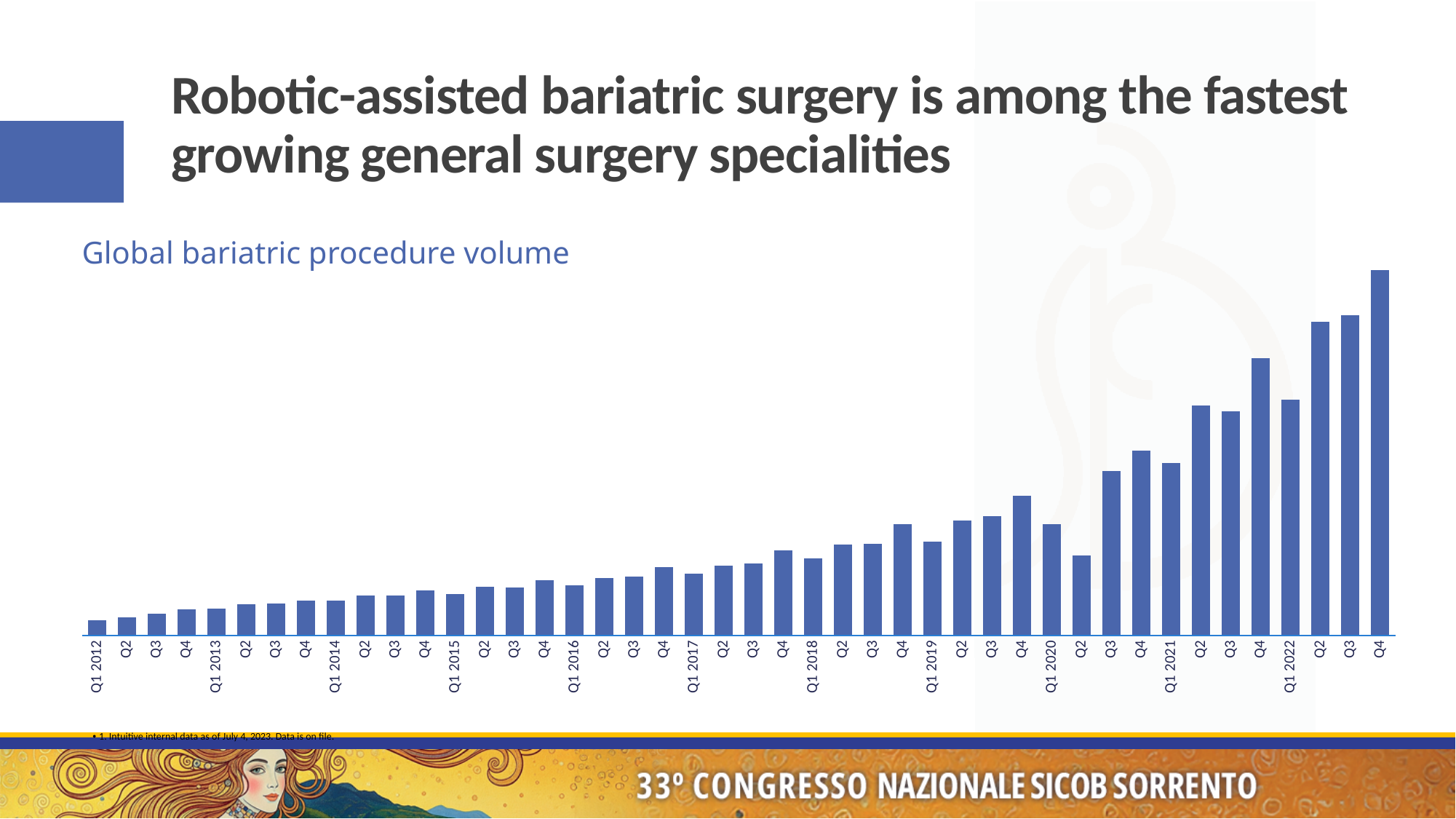
Which is larger, the value for Q1 2020 or the value for Q2 2020? Q1 2020 What is the first quarter shown on the x axis? Q1 2012 Which quarter has the lowest global bariatric procedure volume? Q1 2012 What is the title of the chart? Global bariatric procedure volume Which quarter has the highest global bariatric procedure volume? Q4 2022 What kind of chart is shown on the slide? Bar chart Overall, do the values rise or fall from Q1 2012 to Q4 2022? Rise Which is larger, the value for Q4 2019 or the value for Q1 2020? Q4 2019 Which is larger, the value for Q4 2021 or the value for Q1 2022? Q4 2021 How many quarterly bars are plotted in the chart? 44